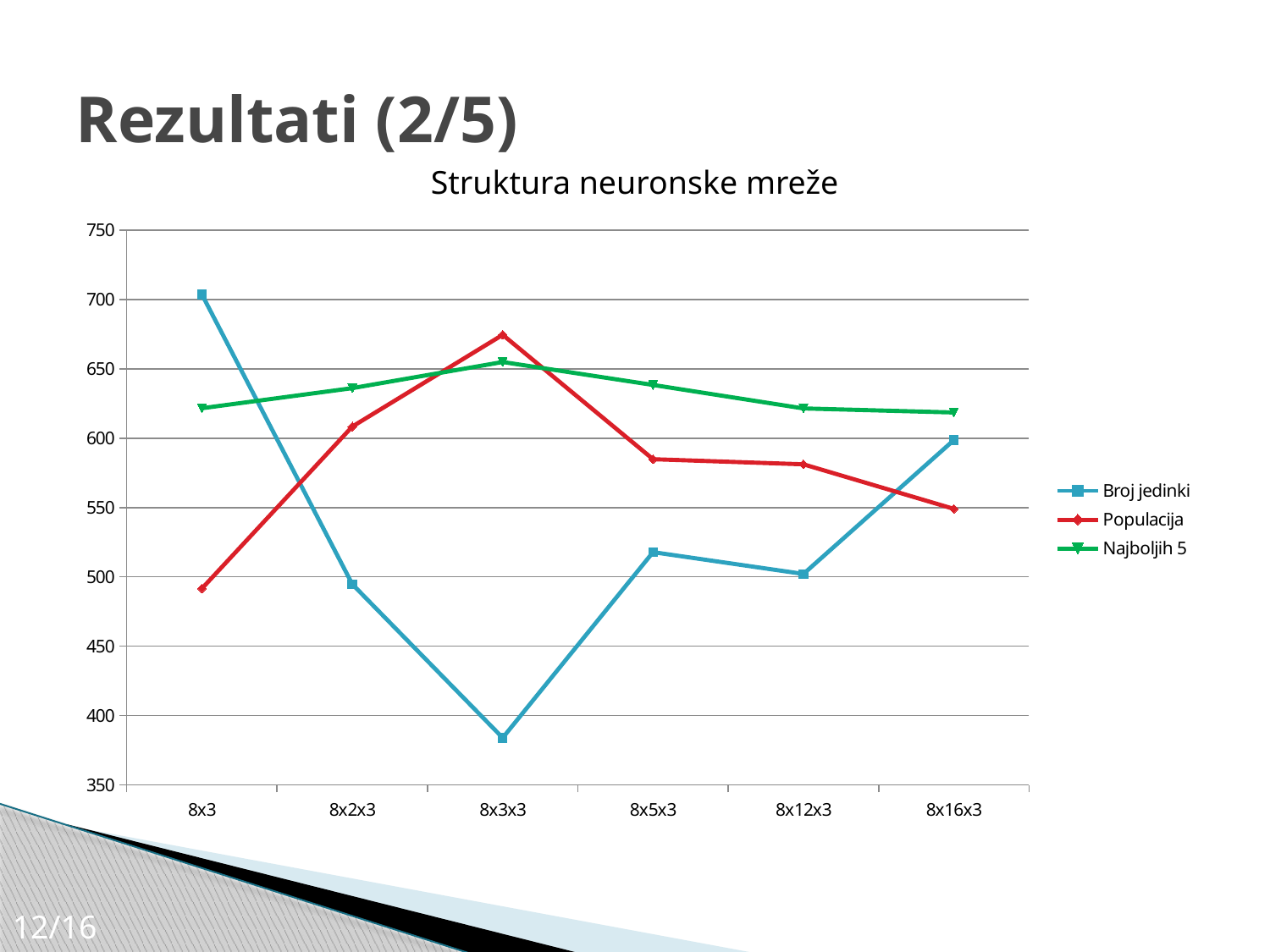
What kind of chart is shown on the slide? line chart For which category is the Broj jedinki series highest? 8x3 For which category is the Broj jedinki series lowest? 8x3x3 For which category is the Populacija series highest? 8x3x3 What is the title of the chart? Struktura neuronske mreže At 8x3, which series has the larger value, Broj jedinki or Populacija? Broj jedinki How many categories are shown on the x axis? 6 For which category is the Populacija series lowest? 8x3 Is the value of Broj jedinki for 8x3 greater or less than 650? greater Does the Najboljih 5 series rise or fall from 8x3x3 to 8x16x3? fall How many series does the legend list? 3 Is the value of Broj jedinki for 8x3x3 greater or less than 400? less